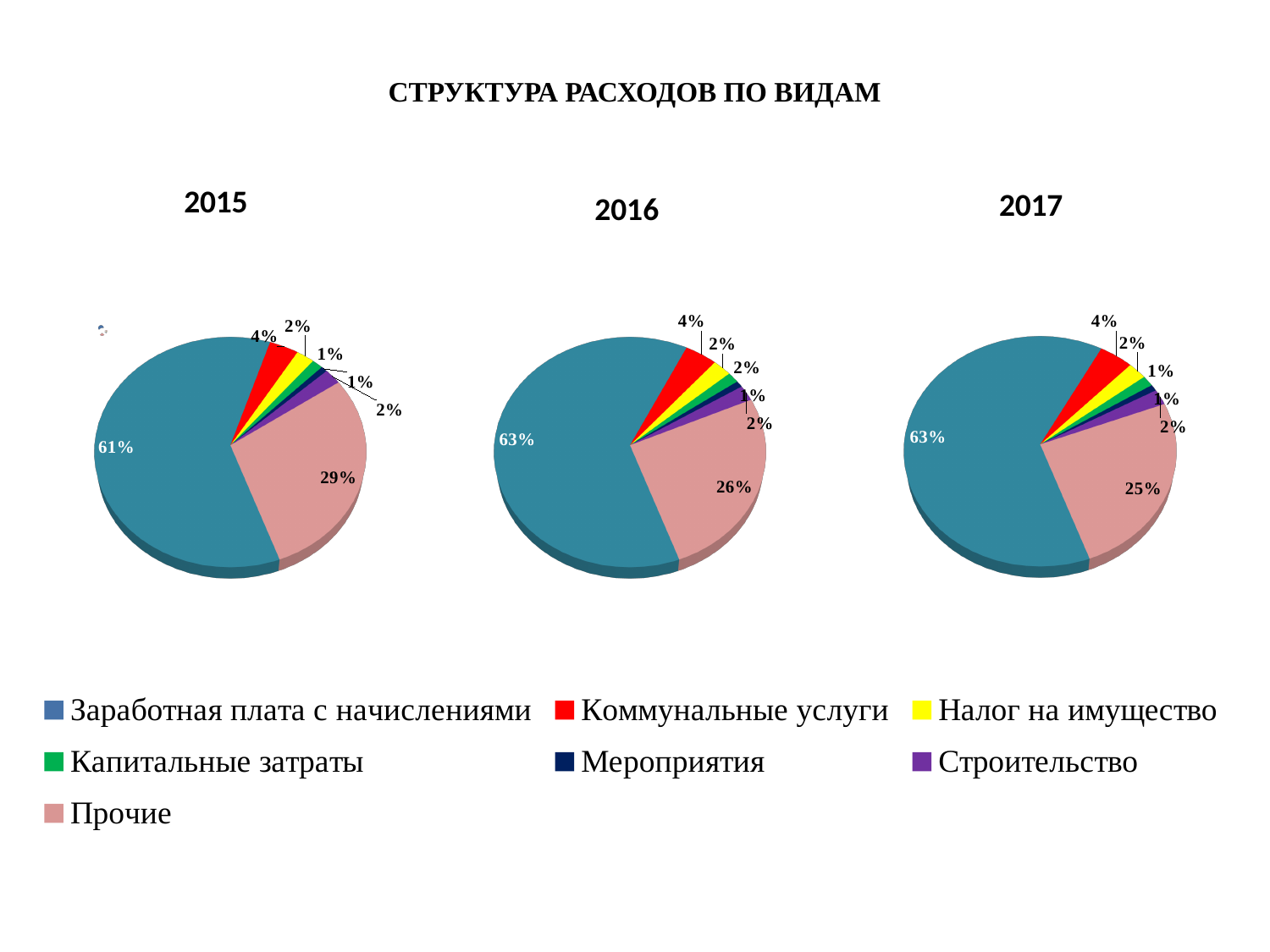
On the 2017 pie chart, what share is shown for Прочие? 25% On the 2015 pie chart, what share is shown for Заработная плата с начислениями? 61% On the 2016 pie chart, what share is shown for Заработная плата с начислениями? 63% What is the title of the slide above the charts? СТРУКТУРА РАСХОДОВ ПО ВИДАМ On the 2017 pie chart, what share is shown for Коммунальные услуги (the red slice)? 4% On the 2016 pie chart, which category has the largest share? Заработная плата с начислениями What kind of chart is used for each year on this slide? Pie chart How many categories does the legend list? 7 Is the share of Прочие larger on the 2015 chart or on the 2017 chart? 2015 On the 2015 pie chart, what share is shown for Прочие? 29% By how many percentage points does the share of Заработная плата с начислениями on the 2016 chart exceed that on the 2015 chart? 2 On the 2016 pie chart, what share is shown for Прочие? 26%